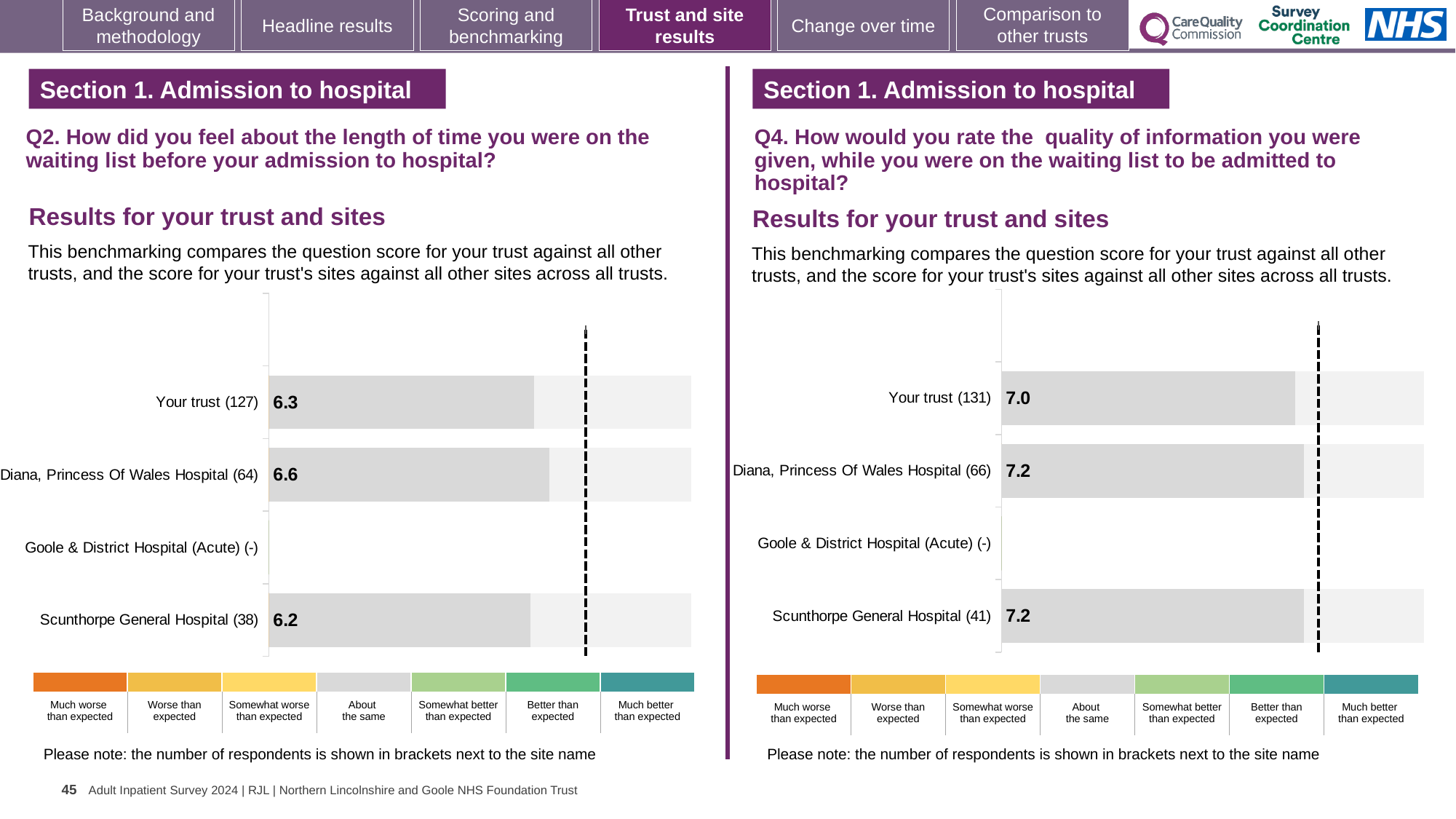
On the Q4 chart (right), what is the difference between the scores for Diana, Princess Of Wales Hospital and Your trust? 0.2 On the Q2 chart (left), what is the score for Scunthorpe General Hospital? 6.2 On the Q2 chart (left), what is the score for Your trust? 6.3 On the Q4 chart (right), how many respondents are shown in brackets for Goole & District Hospital (Acute)? - On the Q4 chart (right), which is larger: the score for Diana, Princess Of Wales Hospital or the score for Your trust? Diana, Princess Of Wales Hospital On the Q4 chart (right), what is the score for Your trust? 7.0 On the Q2 chart (left), what is the difference between the scores for Diana, Princess Of Wales Hospital and Scunthorpe General Hospital? 0.4 On the Q4 chart (right), what is the score for Scunthorpe General Hospital? 7.2 On the Q2 chart (left), what is the score for Diana, Princess Of Wales Hospital? 6.6 What kind of chart is used on the Q2 chart (left)? Bar chart On the Q2 chart (left), how many respondents are shown in brackets for Your trust? 127 On the Q2 chart (left), which site has the highest score? Diana, Princess Of Wales Hospital